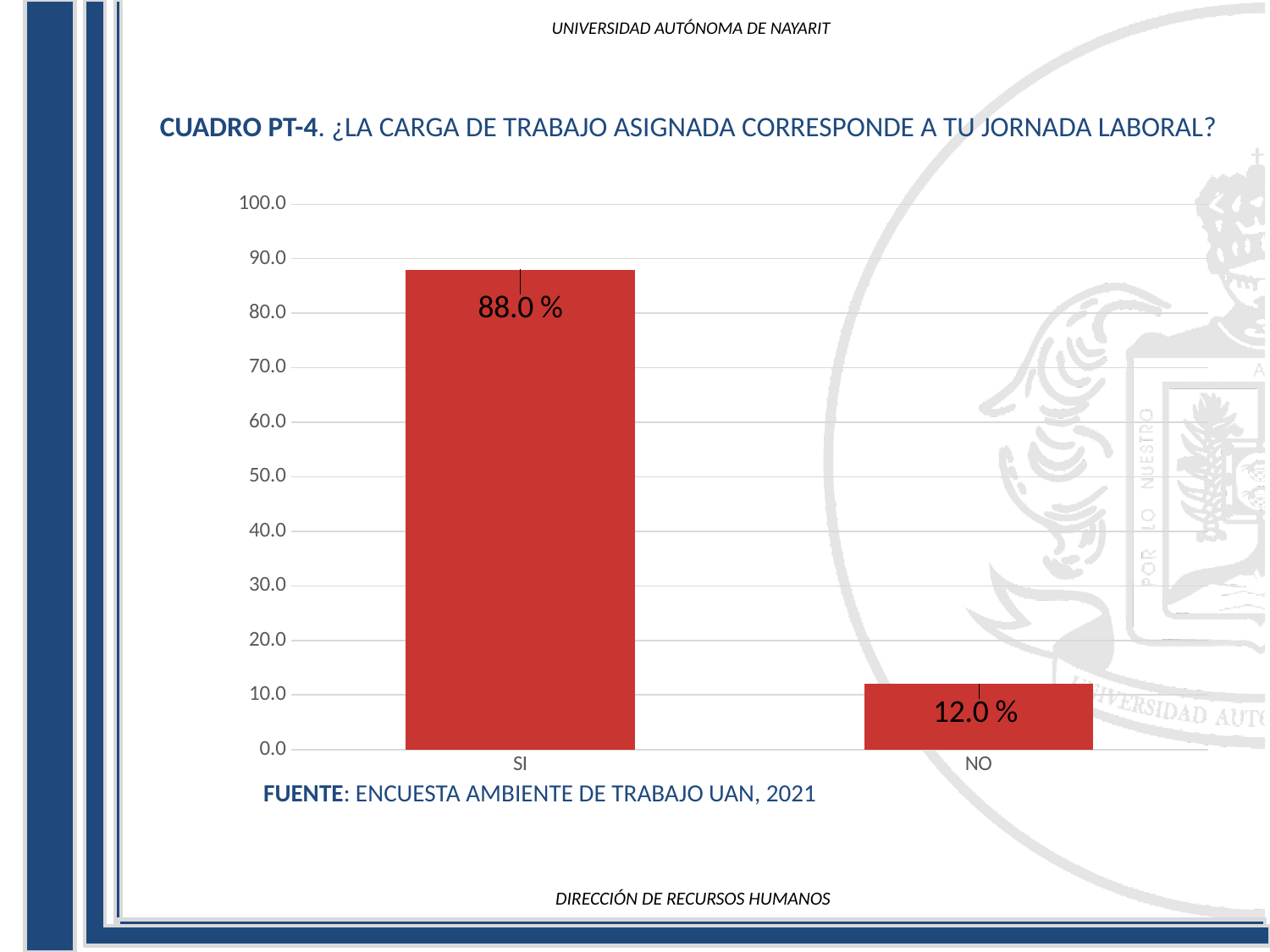
Which category has the highest value? SI What is the total of the values for SI and NO? 100.0 % What is the difference between the values for SI and NO? 76.0 % What kind of chart is shown on the slide? bar chart What is the value for SI? 88.0 % What source is cited below the chart? ENCUESTA AMBIENTE DE TRABAJO UAN, 2021 How many categories are shown on the x axis? 2 Which category has the lowest value? NO Is the value for SI greater or less than 80.0? greater What is the value for NO? 12.0 % Which is larger, the value for SI or the value for NO? SI Is the value for NO greater or less than 20.0? less